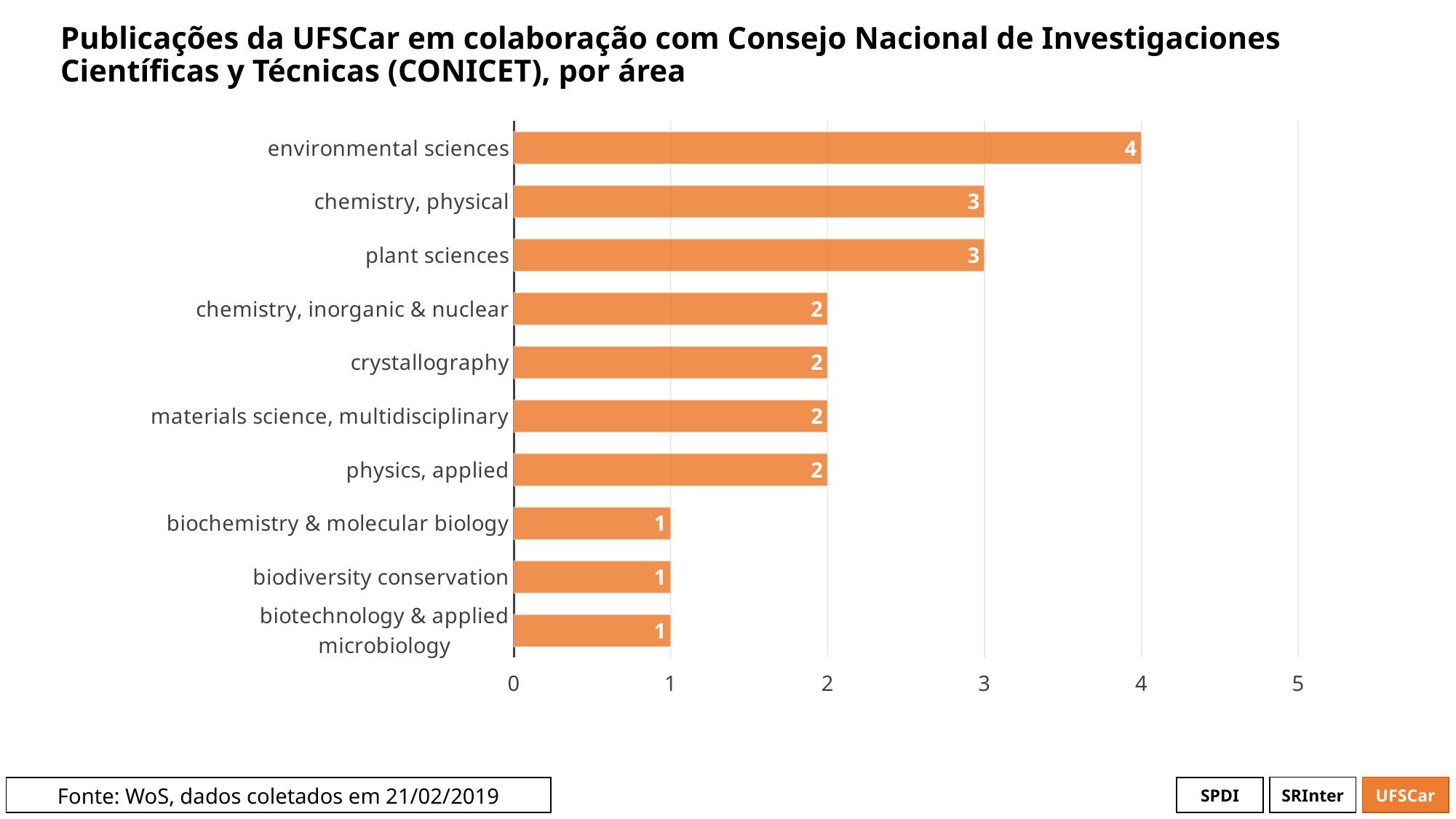
Which is larger, the value for chemistry, physical or the value for chemistry, inorganic & nuclear? chemistry, physical What is the data source stated at the bottom of the slide? WoS, dados coletados em 21/02/2019 Which area has the highest value? environmental sciences Is the value for environmental sciences greater or less than 3? greater What is the value for environmental sciences? 4 What is the value for biodiversity conservation? 1 What is the value for crystallography? 2 What is the value for chemistry, physical? 3 What kind of chart is shown on the slide? bar chart How many areas are shown in the chart? 10 What is the difference between the values for environmental sciences and plant sciences? 1 What is the difference between the values for physics, applied and biochemistry & molecular biology? 1